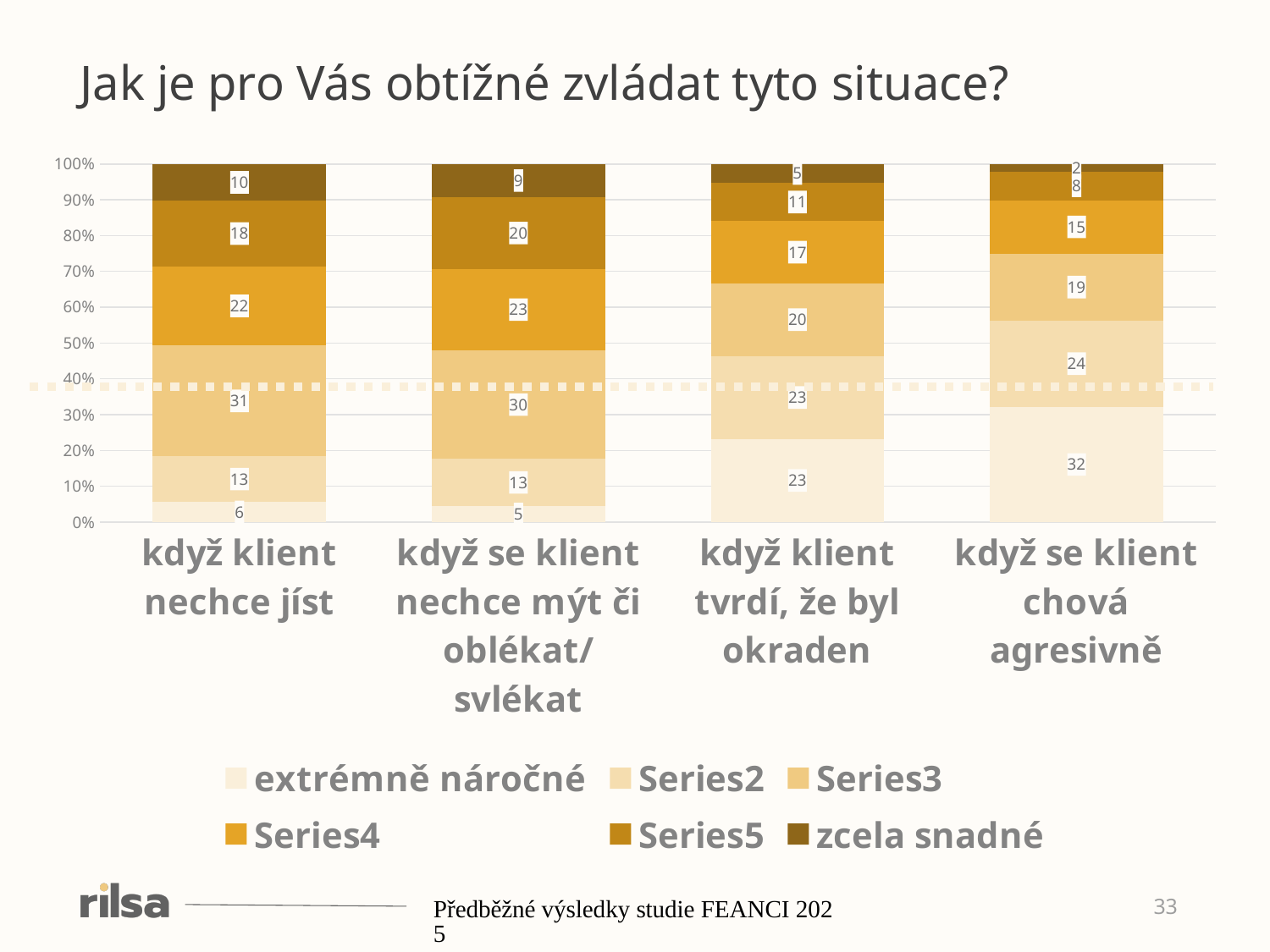
Which category has the highest 'extrémně náročné' value? když se klient chová agresivně How many series does the legend list? 6 What is the value of the 'zcela snadné' segment for 'když se klient nechce mýt či oblékat/svlékat'? 9 Which is larger: the 'zcela snadné' value for 'když klient nechce jíst' or for 'když klient tvrdí, že byl okraden'? když klient nechce jíst What is the title of the chart? Jak je pro Vás obtížné zvládat tyto situace? Which category has the lowest 'zcela snadné' value? když se klient chová agresivně What is the value of the 'zcela snadné' segment for 'když klient nechce jíst'? 10 What is the difference between the 'extrémně náročné' values for 'když se klient chová agresivně' and 'když klient nechce jíst'? 26 What is the value of the 'extrémně náročné' segment for 'když klient tvrdí, že byl okraden'? 23 How many categories (situations) are shown on the x axis? 4 What kind of chart is shown on the slide? stacked bar chart What is the value of the 'extrémně náročné' segment for 'když se klient chová agresivně'? 32